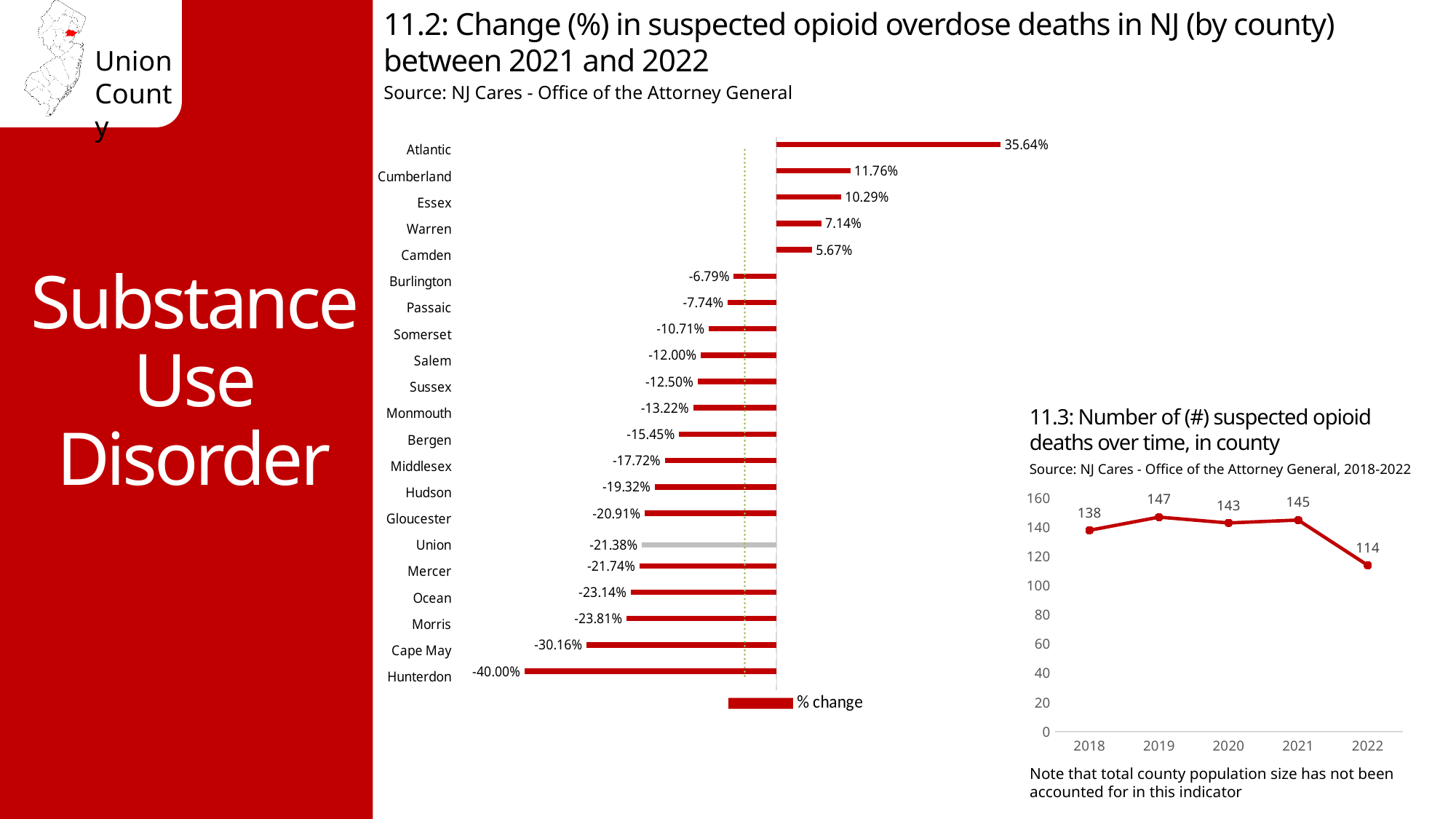
What kind of chart is chart 11.3? Line chart In chart 11.3, how many years are plotted? 5 In chart 11.2, what is the percent change for Union county? -21.38% In chart 11.2, which has a larger percent change, Cumberland or Warren? Cumberland In chart 11.2, how many counties are shown? 21 In chart 11.2, which county has the highest percent change? Atlantic In chart 11.3, which year has the highest number of suspected opioid deaths? 2019 What kind of chart is chart 11.2? Bar chart In chart 11.2, which county has the lowest percent change? Hunterdon In chart 11.3, what is the difference in suspected opioid deaths between 2021 and 2022? 31 In chart 11.3, how many suspected opioid deaths were there in 2022? 114 In chart 11.2, what is the percent change for Essex? 10.29%